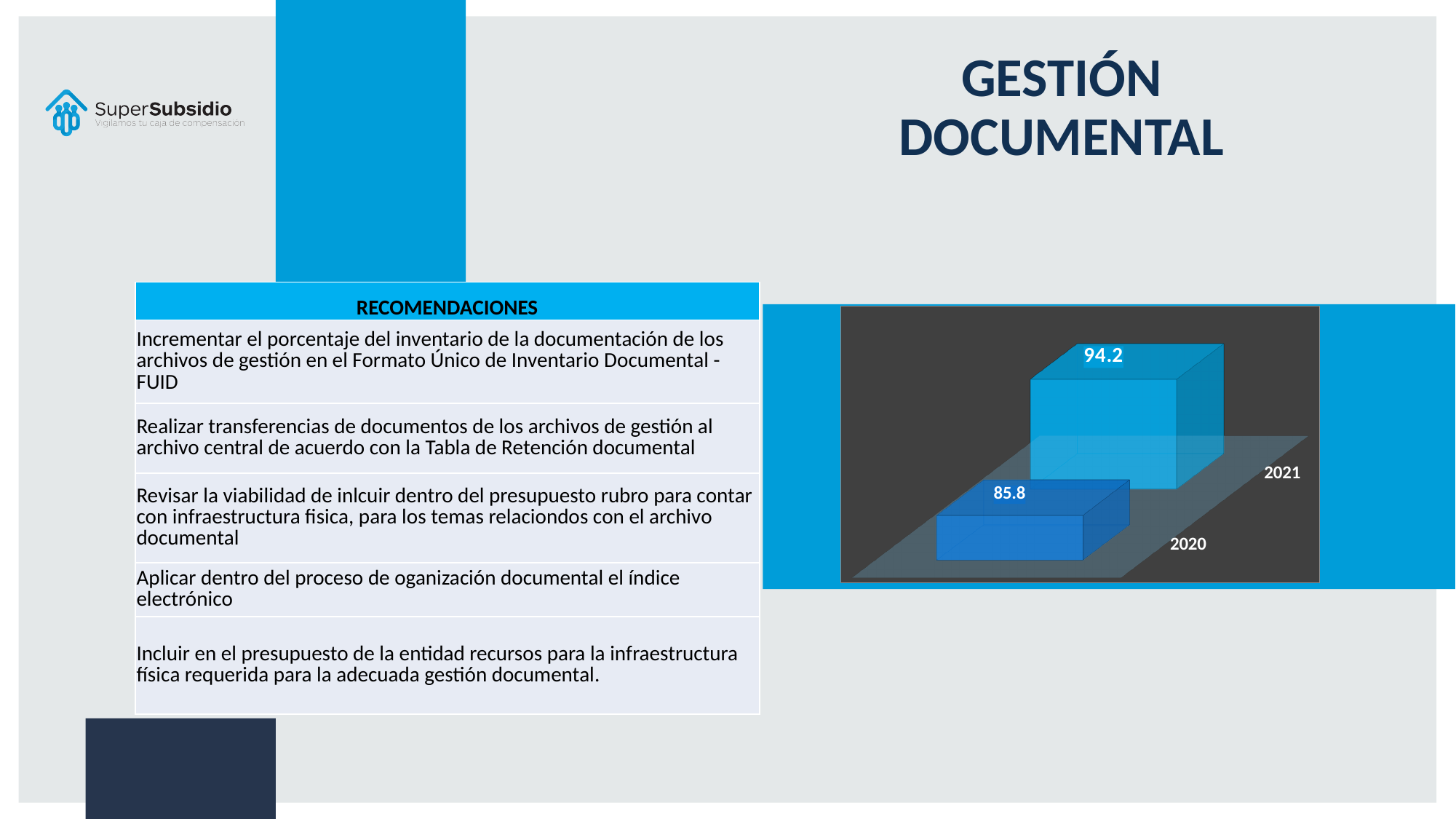
Which year has the lower value in the chart? 2020 What is the difference between the 2021 and 2020 values in the chart? 8.4 What is the value shown for 2020 in the chart? 85.8 Do the values rise or fall from 2020 to 2021? rise Which year has the higher value in the chart? 2021 What kind of chart is shown on the slide? bar chart What is the background colour of the chart area? dark grey Is the value for 2020 larger or smaller than the value for 2021? smaller What is the title of the slide containing the chart? GESTIÓN DOCUMENTAL How many years are plotted in the chart? 2 What is the value shown for 2021 in the chart? 94.2